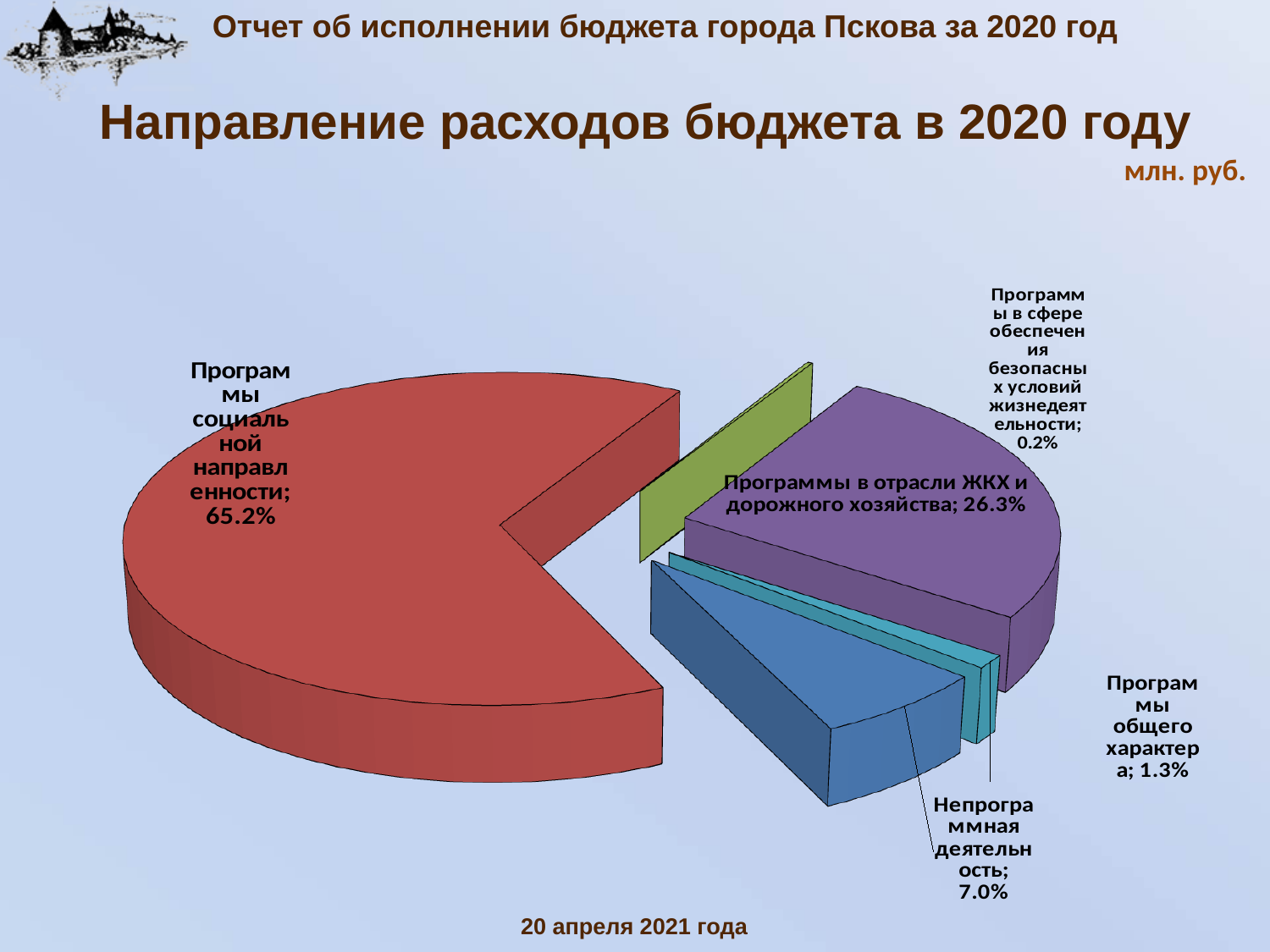
What percentage is labelled for "Непрограммная деятельность"? 7.0% What share is shown for "Программы в отрасли ЖКХ и дорожного хозяйства"? 26.3% Which is larger: the share for "Непрограммная деятельность" or for "Программы общего характера"? Непрограммная деятельность What is the difference in percentage points between "Программы социальной направленности" and "Программы в отрасли ЖКХ и дорожного хозяйства"? 38.9 What share is shown for "Программы в сфере обеспечения безопасных условий жизнедеятельности"? 0.2% Which category has the smallest share of the pie? Программы в сфере обеспечения безопасных условий жизнедеятельности Which category has the largest share of the pie? Программы социальной направленности How many slices does the pie chart have? 5 What type of chart is shown on the slide? Pie chart What share of the pie does "Программы социальной направленности" have? 65.2% What is the title of the chart on the slide? Направление расходов бюджета в 2020 году What share is shown for "Программы общего характера"? 1.3%